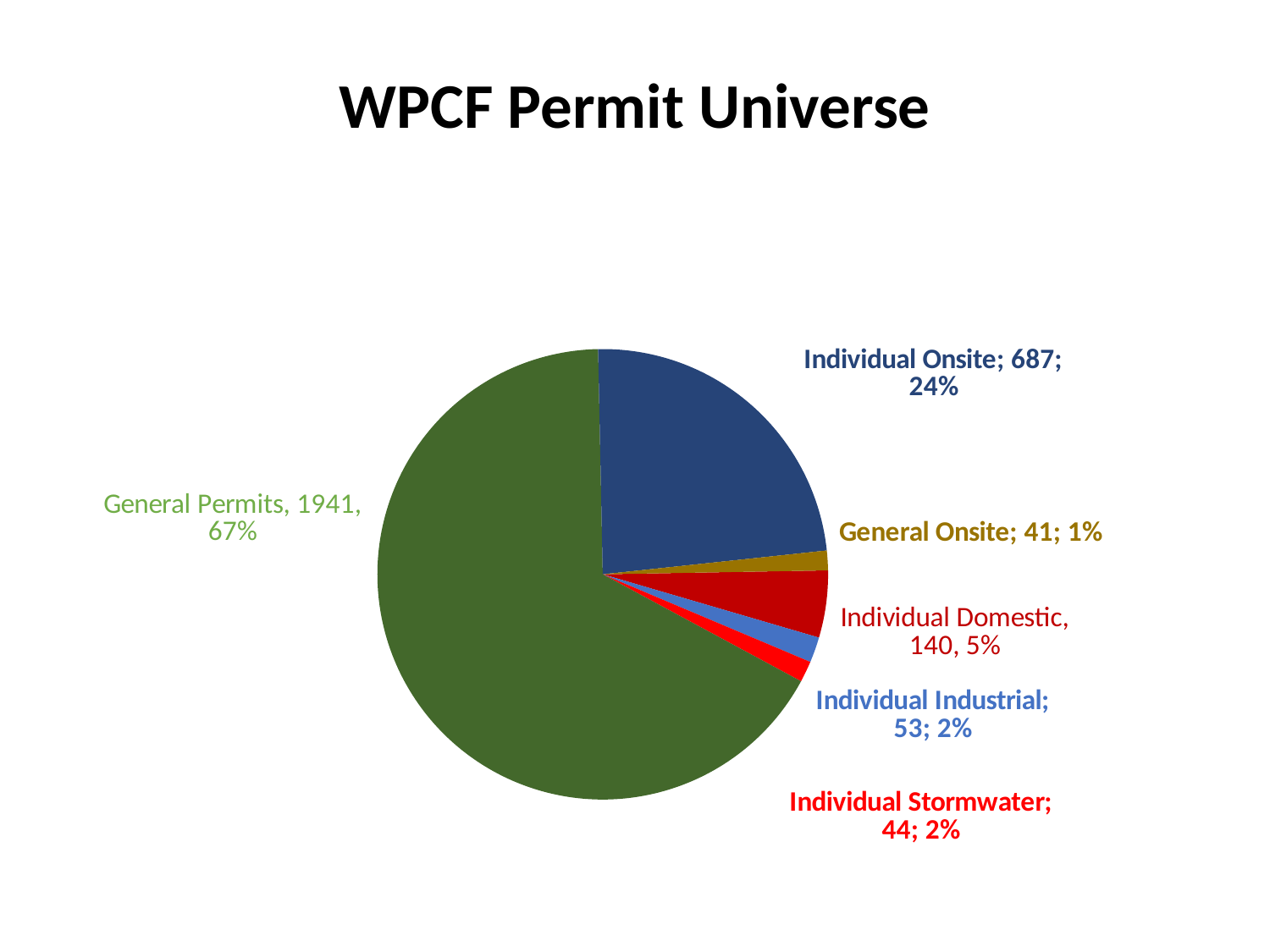
What share of the pie does Individual Onsite represent? 24% What is the difference between the values for Individual Onsite and Individual Domestic? 547 What is the value for Individual Industrial? 53 Which category has the smallest slice? General Onsite What is the value for Individual Domestic? 140 Which is larger, Individual Industrial or Individual Stormwater? Individual Industrial How many slices does the pie chart have? 6 What is the value for Individual Onsite? 687 What is the value for General Permits? 1941 What is the title of the chart? WPCF Permit Universe What type of chart is shown on the slide? pie chart Which category has the largest slice? General Permits